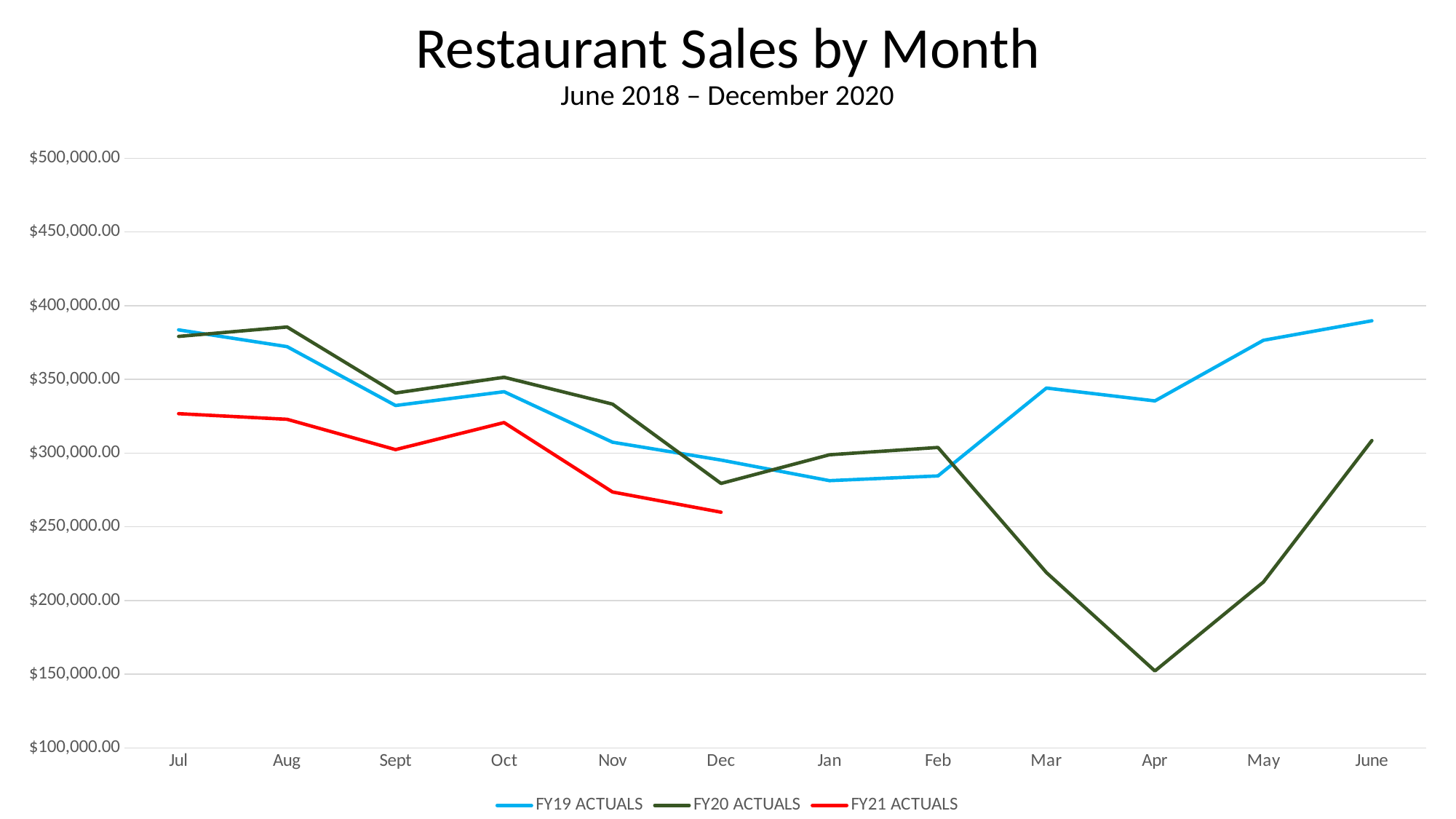
In Apr, which series has the higher value, FY19 ACTUALS or FY20 ACTUALS? FY19 ACTUALS What is the title of the chart? Restaurant Sales by Month In Jul, which series has the higher value, FY19 ACTUALS or FY21 ACTUALS? FY19 ACTUALS Is the FY21 ACTUALS value for Jul greater or less than $300,000.00? greater In which month is the FY20 ACTUALS value lowest? Apr How many months are shown along the x axis? 12 What kind of chart is shown on the slide? line chart In which month is the FY21 ACTUALS value lowest? Dec Is the FY20 ACTUALS value for Apr greater or less than $200,000.00? less Is the FY19 ACTUALS value for June greater or less than $350,000.00? greater Do the FY21 ACTUALS values generally rise or fall from Jul to Dec? fall How many series does the legend list? 3